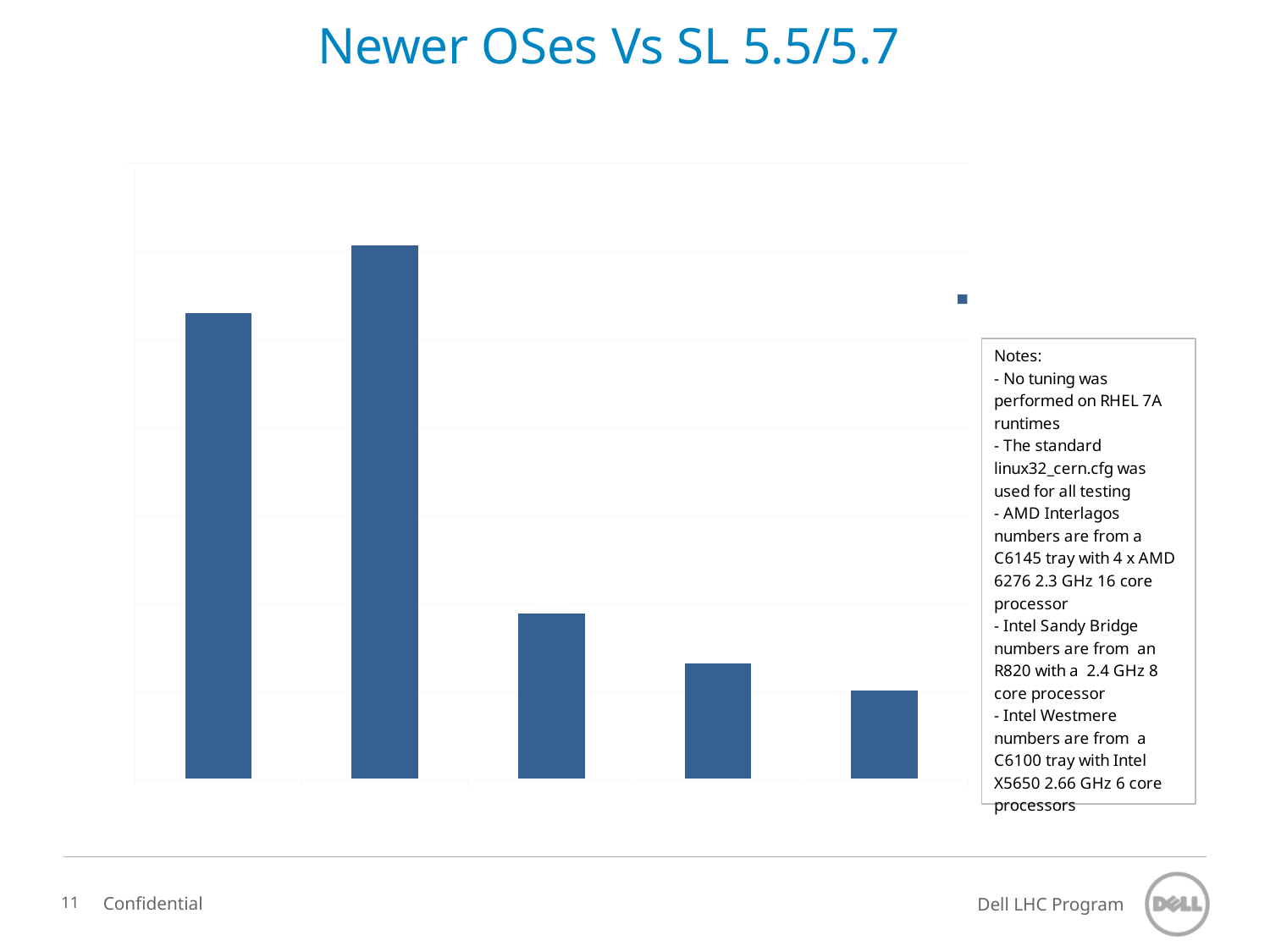
Is the third bar from the left taller or shorter than the fifth bar? taller Which bar, counting from the left, is the tallest in the chart? the second bar Is the fourth bar from the left taller or shorter than the second bar? shorter What kind of chart is shown on the slide? bar chart From the second bar onward, do the bar heights rise or fall moving left to right? fall Is the first bar from the left taller or shorter than the third bar? taller What is the title of the slide containing the chart? Newer OSes Vs SL 5.5/5.7 How many bars are plotted in the chart? 5 What colour are the bars in the chart? blue Which bar, counting from the left, is the shortest in the chart? the fifth bar